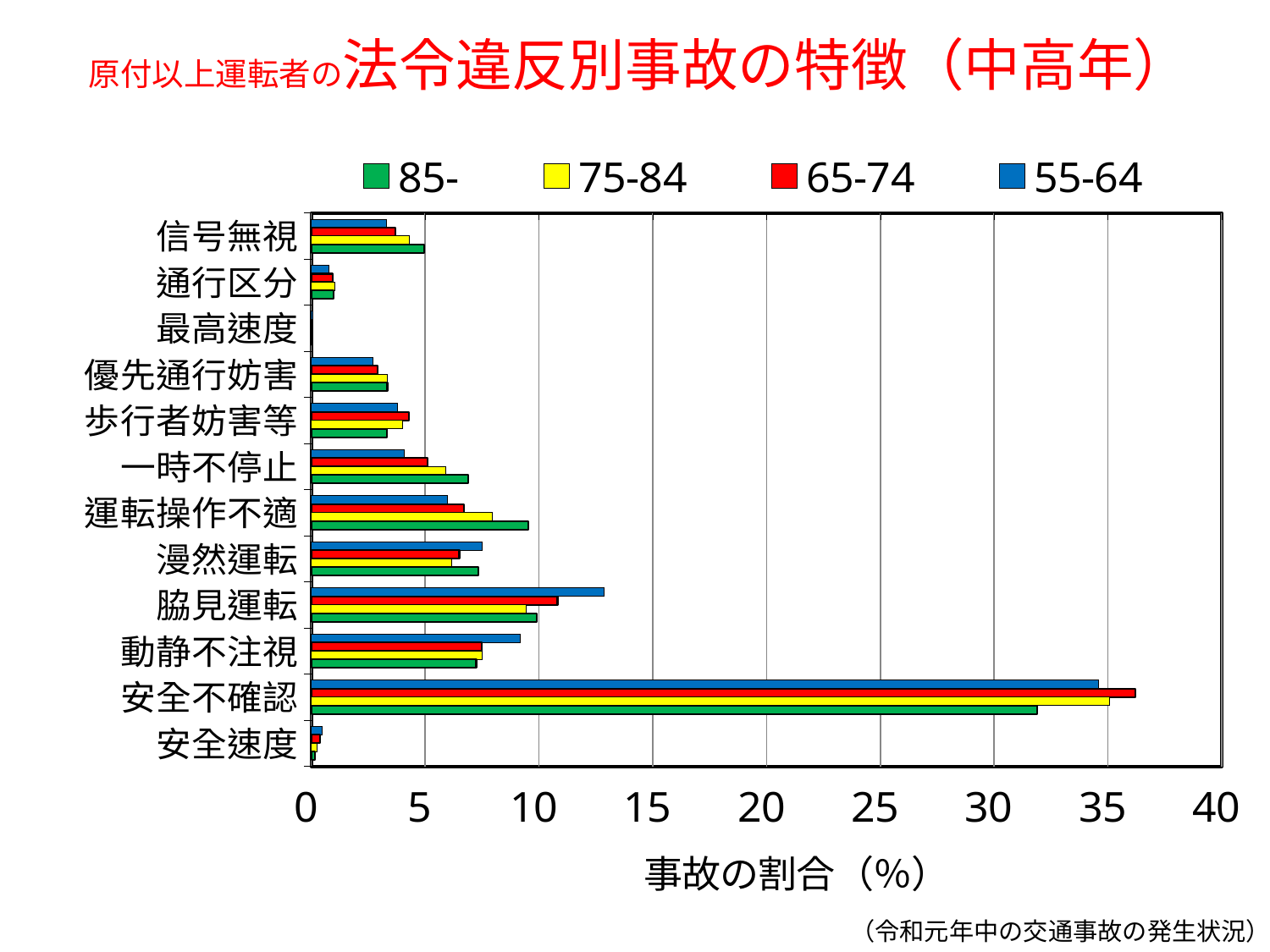
Which category has the highest value for the 55-64 series? 安全不確認 What is the label of the x axis? 事故の割合（%） Which category has the lowest values across all series? 最高速度 How many violation categories are plotted on the y axis? 12 For 脇見運転, which series has the highest value? 55-64 For 脇見運転, which is larger: the 55-64 value or the 65-74 value? 55-64 Is the value for 一時不停止 in the 85- series greater or less than 5? greater What kind of chart is shown on the slide? bar chart For 安全不確認, which is larger: the 65-74 value or the 85- value? 65-74 Is the value for 脇見運転 in the 55-64 series greater or less than 10? greater How many series does the legend list? 4 Is the value for 安全不確認 in the 85- series greater or less than 30? greater